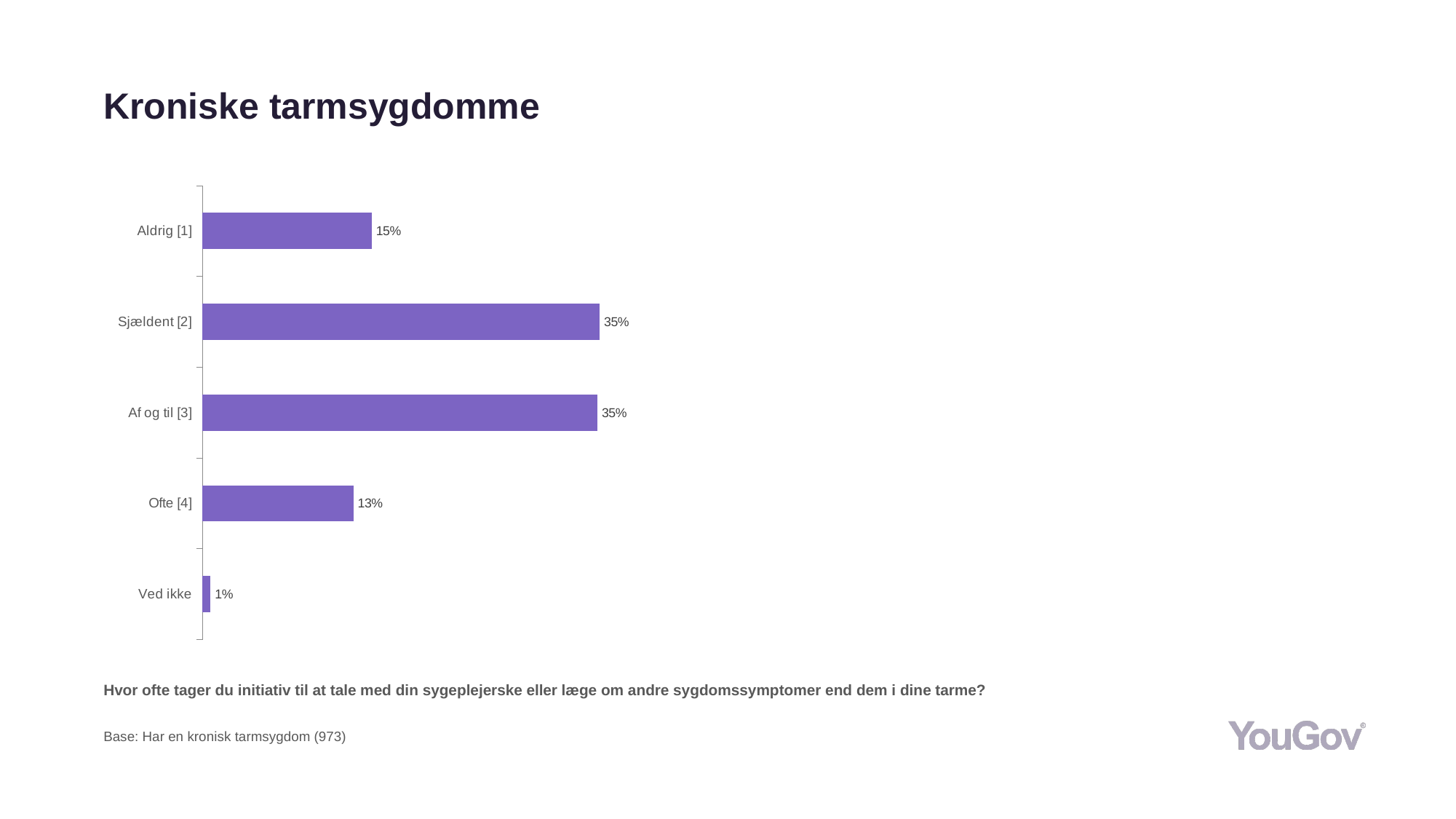
What is the difference between the values for Sjældent [2] and Aldrig [1]? 20% Which is larger, the value for Af og til [3] or the value for Ved ikke? Af og til [3] What is the value for Sjældent [2]? 35% What is the title of the slide? Kroniske tarmsygdomme What is the value for Ved ikke? 1% What kind of chart is shown on the slide? Bar chart Which category has the lowest value? Ved ikke Which is larger, the value for Aldrig [1] or the value for Ofte [4]? Aldrig [1] What is the value for Ofte [4]? 13% How many categories are shown in the chart? 5 What is the difference between the values for Aldrig [1] and Ofte [4]? 2% What is the value for Aldrig [1]? 15%